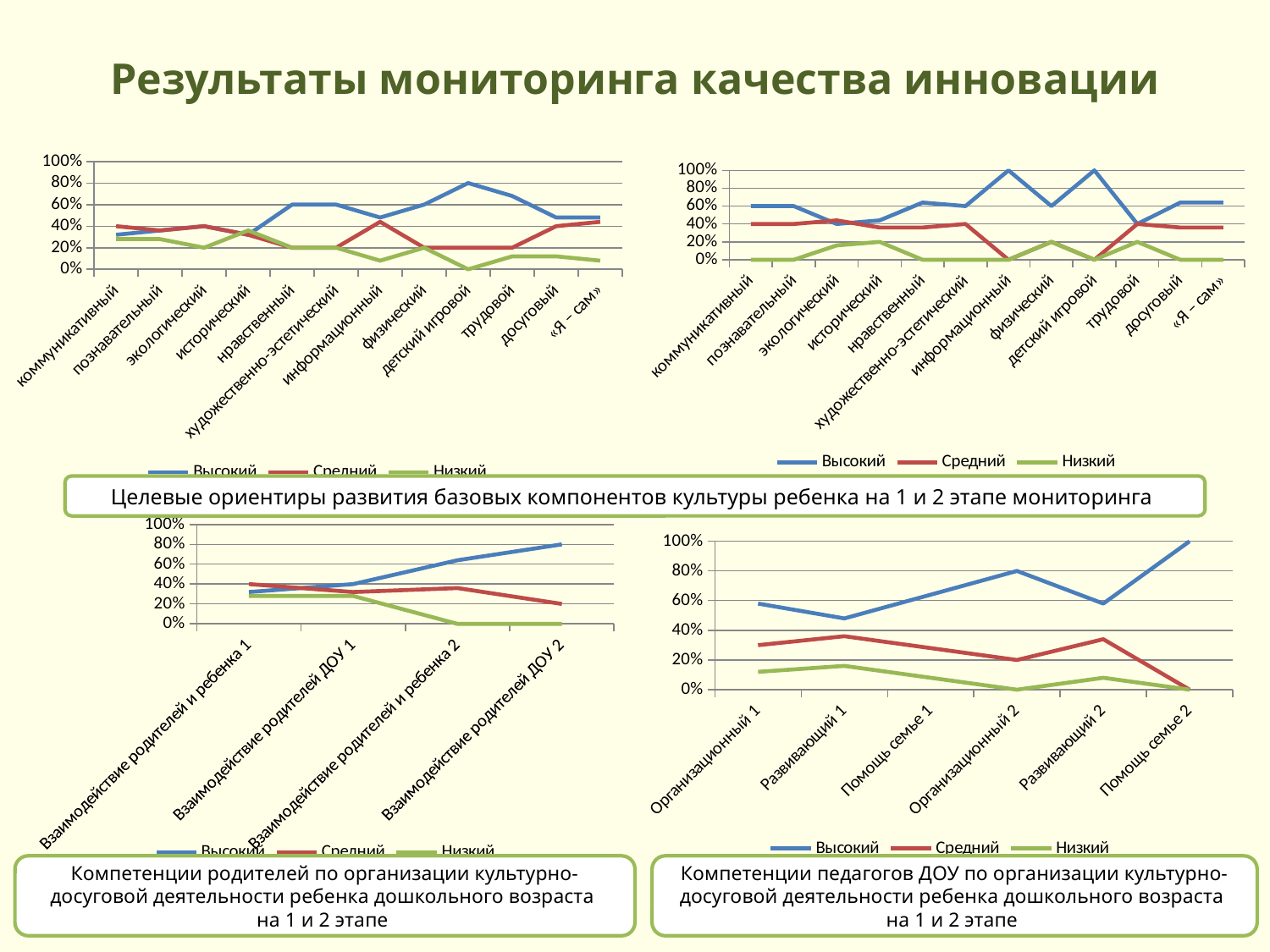
In the top-right chart, what is the value of the Высокий series for физический? 60% How many categories are shown on the x axis of the bottom-right chart? 6 In the bottom-right chart, which category has the highest value for the Высокий series? Помощь семье 2 What kind of chart is the top-left chart on the slide? line chart In the bottom-right chart, what is the value of the Высокий series for Помощь семье 2? 100% In the bottom-right chart, what is the value of the Высокий series for Организационный 2? 80% In the top-left chart, is the value of the Высокий series for нравственный greater or less than 40%? greater In the bottom-left chart, what is the value of the Низкий series for Взаимодействие родителей и ребенка 2? 0% How many series does the legend of the top-right chart list? 3 How many categories are shown on the x axis of the top-left chart? 12 In the bottom-left chart, what is the value of the Высокий series for Взаимодействие родителей ДОУ 2? 80% In the top-right chart, what is the value of the Низкий series for коммуникативный? 0%